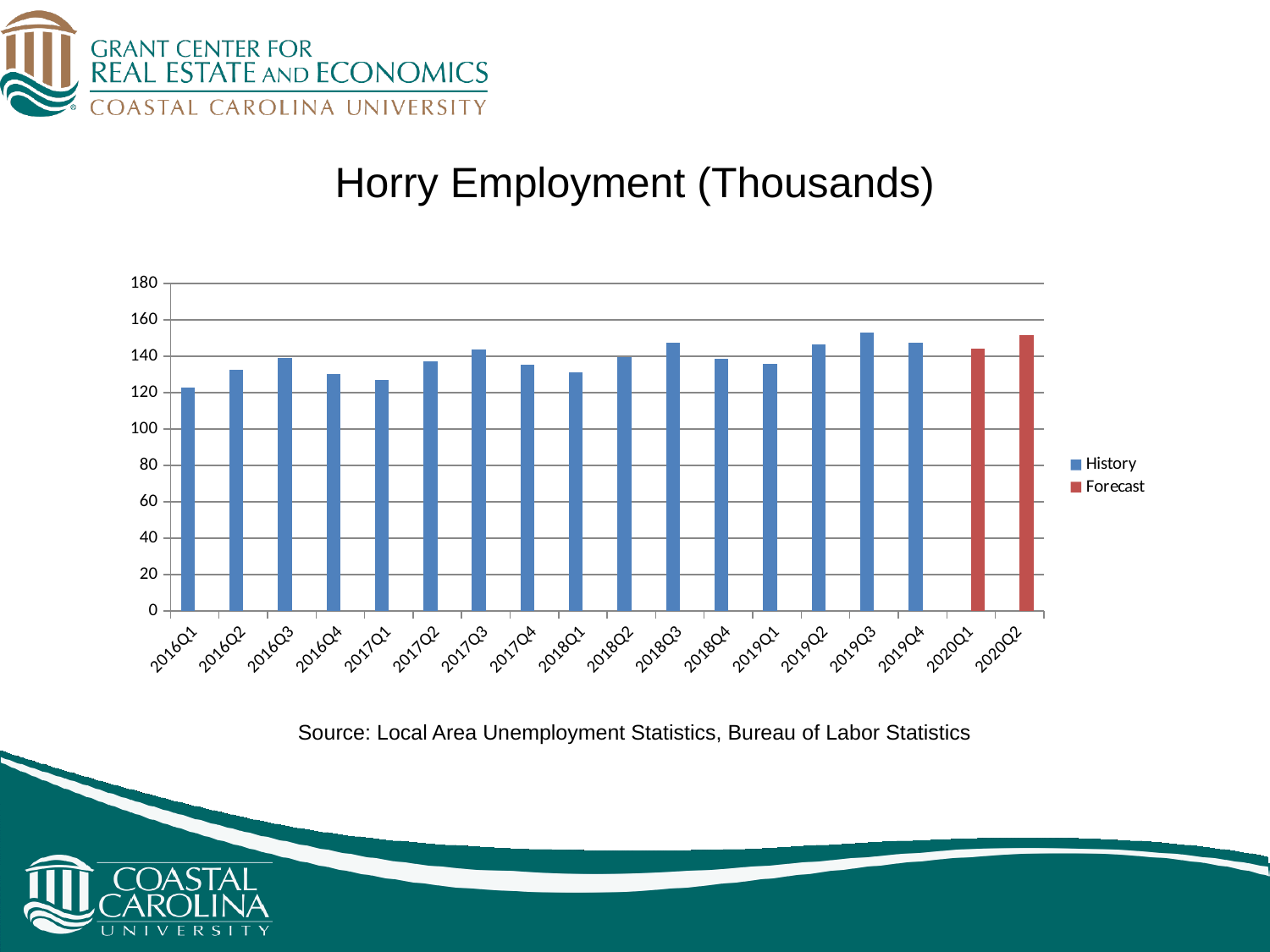
Which is larger, the value for 2016Q1 or the value for 2019Q3? 2019Q3 What kind of chart is shown on the slide? bar chart Is the value for 2016Q1 greater or less than 140? less Is the value for 2019Q3 greater or less than 140? greater What are the two series named in the legend? History and Forecast How many series does the legend list? 2 How many quarters are shown on the x axis? 18 Which quarter has the lowest employment value? 2016Q1 Is the value for 2017Q1 greater or less than 140? less Overall, do the employment values rise or fall from 2016Q1 to 2020Q2? rise What is the title of the chart? Horry Employment (Thousands)